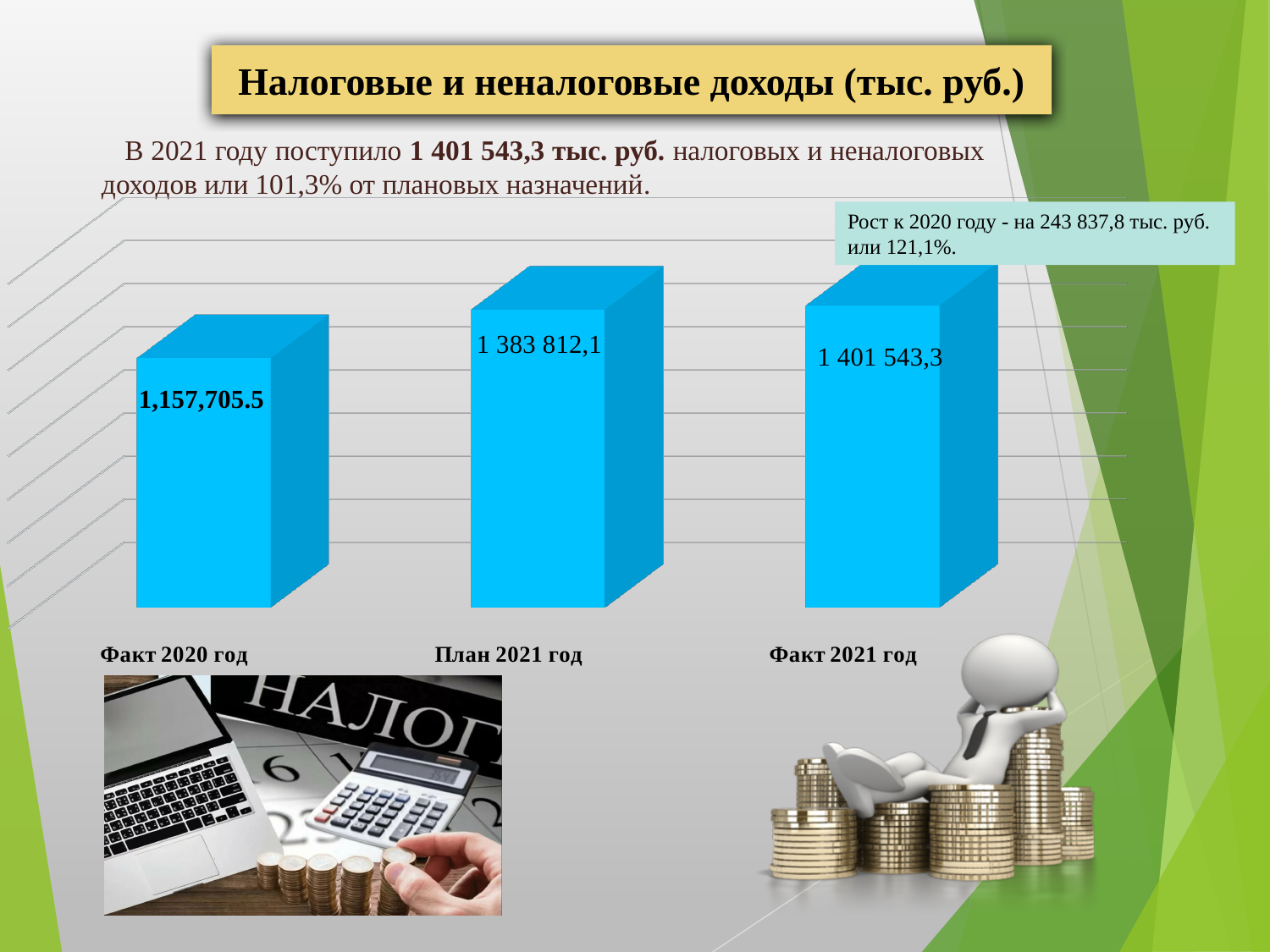
What is the difference between Факт 2021 год and Факт 2020 год? 243 837,8 Which category has the lowest value? Факт 2020 год What is the value for Факт 2020 год? 1,157,705.5 Which category has the highest value? Факт 2021 год What is the value for Факт 2021 год? 1 401 543,3 What is the title of the chart? Налоговые и неналоговые доходы (тыс. руб.) What is the value for План 2021 год? 1 383 812,1 Which is larger, Факт 2021 год or План 2021 год? Факт 2021 год Do the values rise or fall from left to right across the categories? Rise How many bars are shown in the chart? 3 What kind of chart is shown on the slide? Bar chart What is the difference between Факт 2021 год and План 2021 год? 17 731,2